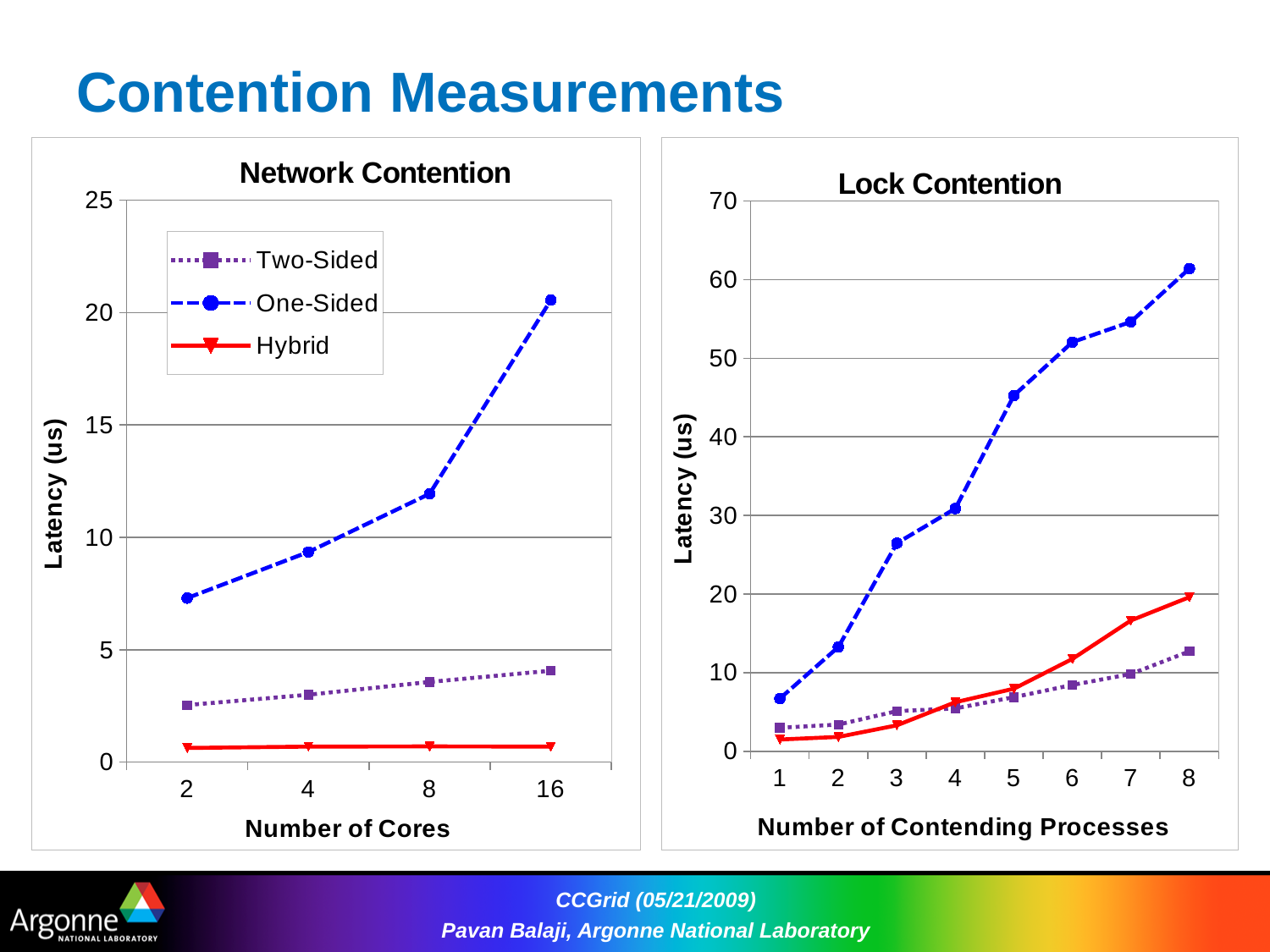
What is the y-axis label of the Lock Contention chart? Latency (us) In the Network Contention chart, is the Hybrid latency at 2 cores greater or less than 5? less In the Network Contention chart, how many Number of Cores values are plotted along the x axis? 4 In the Lock Contention chart, how many Number of Contending Processes values are plotted along the x axis? 8 In the Lock Contention chart, does the One-Sided latency rise or fall as the number of contending processes increases? rises In the Lock Contention chart, is the One-Sided latency at 8 contending processes greater or less than 50? greater What kind of chart is the Network Contention chart? line chart In the Network Contention chart, which series has the highest latency at 16 cores? One-Sided In the Network Contention chart, which series has the lowest latency at 16 cores? Hybrid How many series does the legend on the Network Contention chart list? 3 In the Lock Contention chart, which is larger at 8 contending processes, the Hybrid latency or the Two-Sided latency? Hybrid In the Network Contention chart, is the One-Sided latency at 8 cores greater or less than 10? greater